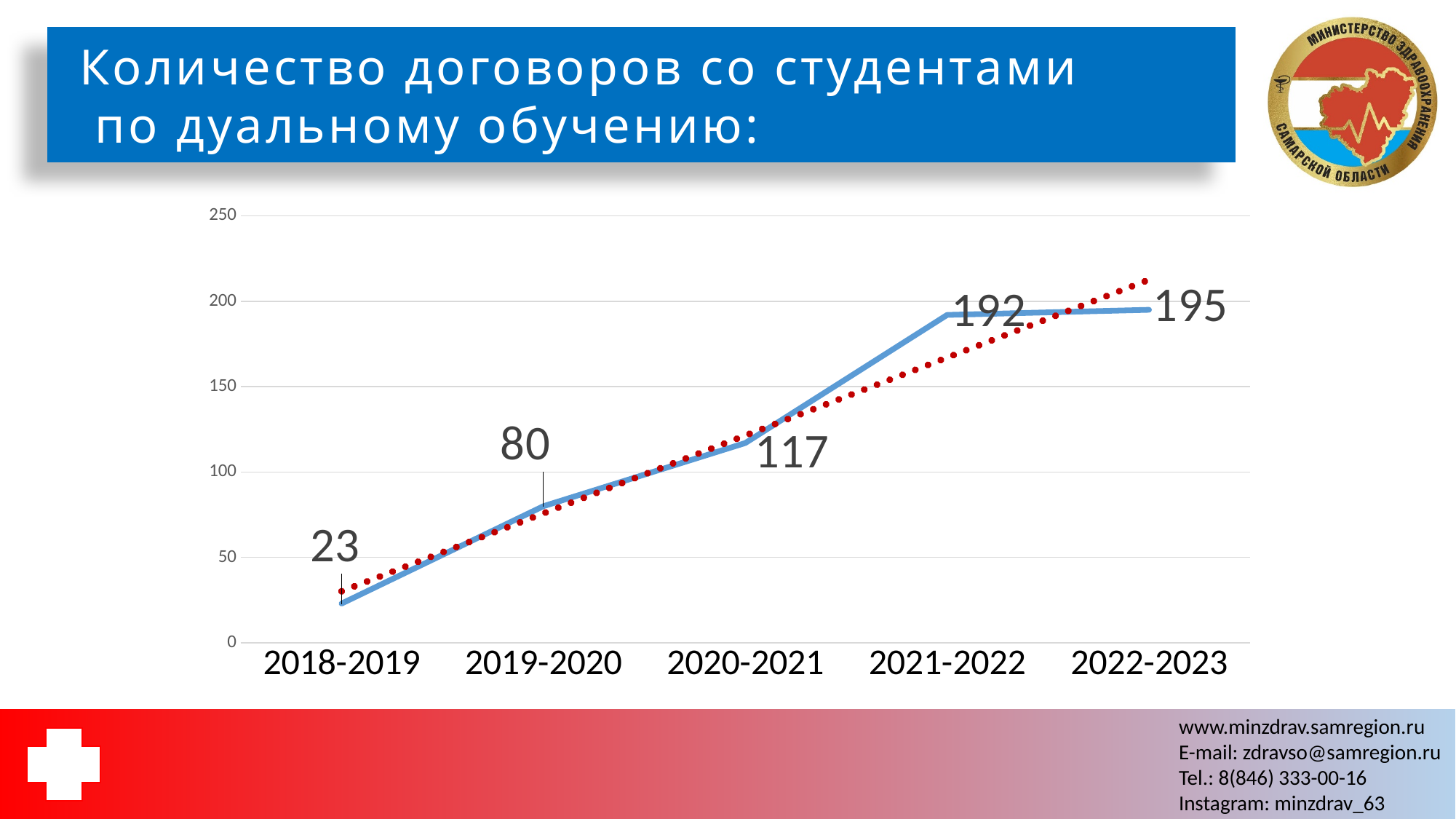
What is the number of contracts for 2019-2020? 80 What is the number of contracts for 2022-2023? 195 Which is larger, the value for 2019-2020 or the value for 2020-2021? 2020-2021 Which academic year has the lowest number of contracts? 2018-2019 Do the values rise or fall from 2018-2019 to 2022-2023? rise Which academic year has the highest number of contracts? 2022-2023 What is the number of contracts for 2018-2019? 23 How many academic years are plotted on the x axis? 5 What is the difference between the values for 2021-2022 and 2020-2021? 75 What is the number of contracts for 2021-2022? 192 What is the number of contracts for 2020-2021? 117 What kind of chart is shown on the slide? line chart